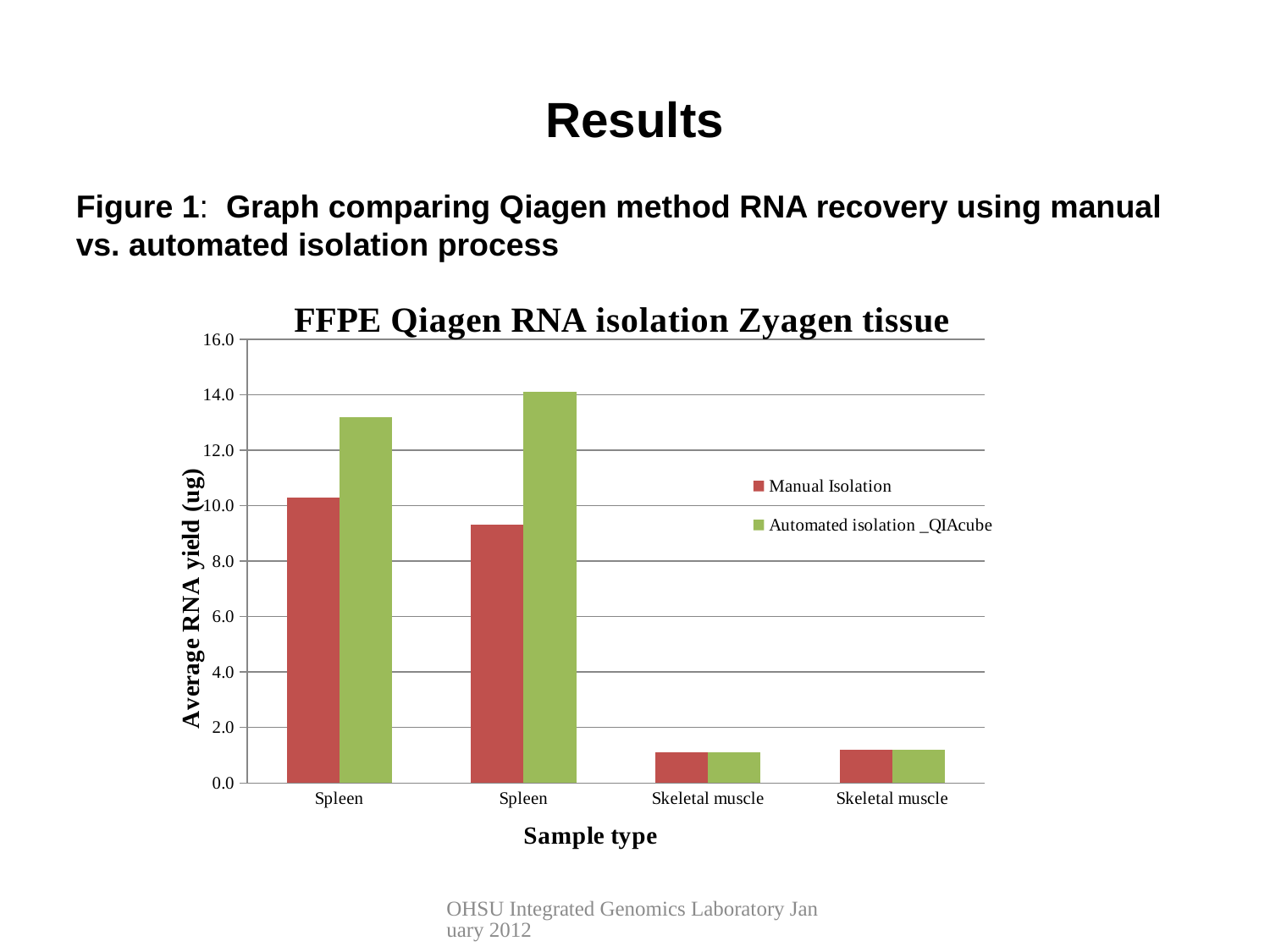
In the second Spleen group, is the Automated isolation _QIAcube value greater or less than 12.0? greater How many series does the legend list? 2 In the leftmost Spleen group, is the Manual Isolation value greater or less than 8.0? greater What is the title of the chart? FFPE Qiagen RNA isolation Zyagen tissue What is the label of the y axis? Average RNA yield (ug) In the leftmost Spleen group, is the Automated isolation _QIAcube value greater or less than 12.0? greater Which tissue type has the lowest RNA yield values, Spleen or Skeletal muscle? Skeletal muscle What kind of chart is shown on the slide? bar chart In the leftmost Spleen group, which series has the larger value, Manual Isolation or Automated isolation _QIAcube? Automated isolation _QIAcube How many category groups are shown along the x axis? 4